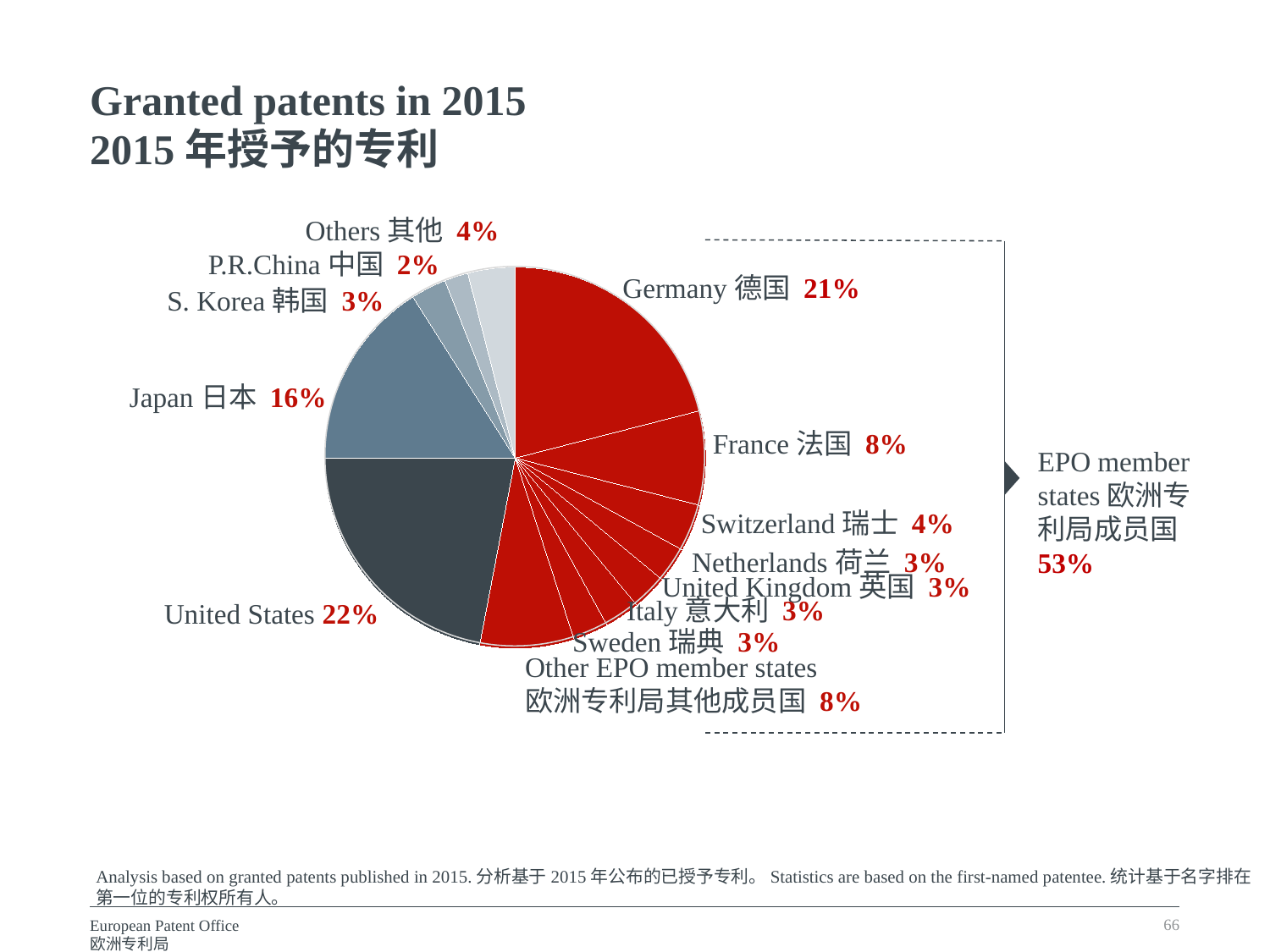
What is the difference in percentage points between the United States' share and Japan's share? 6 How many slices does the pie chart have? 13 What share of granted patents in 2015 does Germany hold? 21% Which has a larger share of granted patents in 2015, France or Switzerland? France What is the title of the chart on the slide? Granted patents in 2015 Which named country has the smallest share of granted patents in 2015? P.R.China What share of granted patents in 2015 does P.R. China hold? 2% What share of granted patents in 2015 does the United States hold? 22% What share of granted patents in 2015 does Japan hold? 16% What is the combined share of all EPO member states shown on the slide? 53% What type of chart is shown on the slide? Pie chart Which country has the largest share of granted patents in 2015? United States